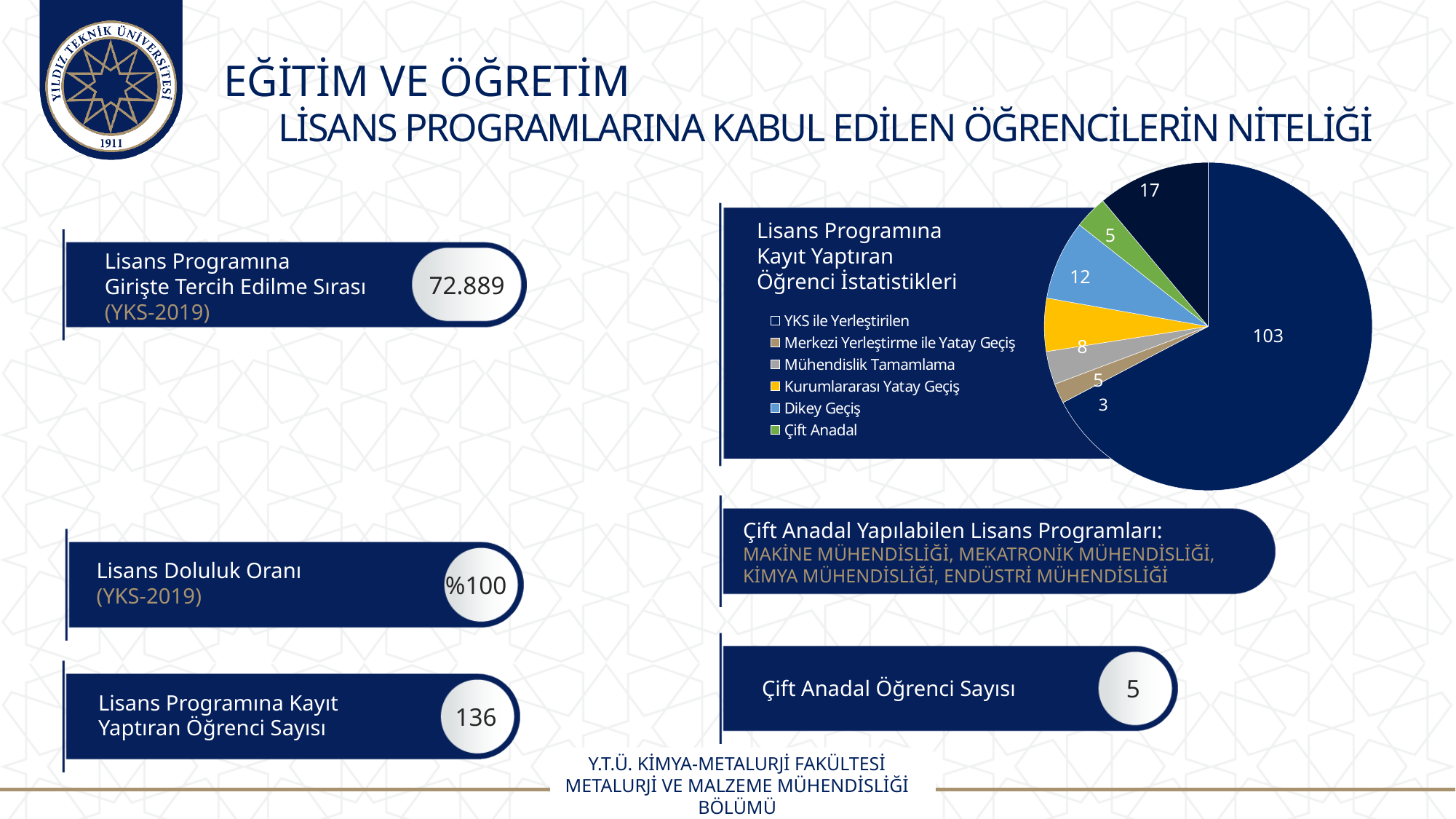
What is the value for YKS ile Yerleştirilen in the pie chart? 103 What is the value for Kurumlararası Yatay Geçiş in the pie chart? 8 What is the value for Çift Anadal in the pie chart? 5 What is the value for Merkezi Yerleştirme ile Yatay Geçiş in the pie chart? 3 Which legend category has the smallest slice in the pie chart? Merkezi Yerleştirme ile Yatay Geçiş Which legend category has the largest slice in the pie chart? YKS ile Yerleştirilen What is the value for Dikey Geçiş in the pie chart? 12 What is the title of the pie chart? Lisans Programına Kayıt Yaptıran Öğrenci İstatistikleri How many entries does the legend of the pie chart list? 6 What kind of chart is shown on the slide? pie chart What is the difference between the values for Dikey Geçiş and Kurumlararası Yatay Geçiş in the pie chart? 4 Which is larger in the pie chart, Dikey Geçiş or Kurumlararası Yatay Geçiş? Dikey Geçiş